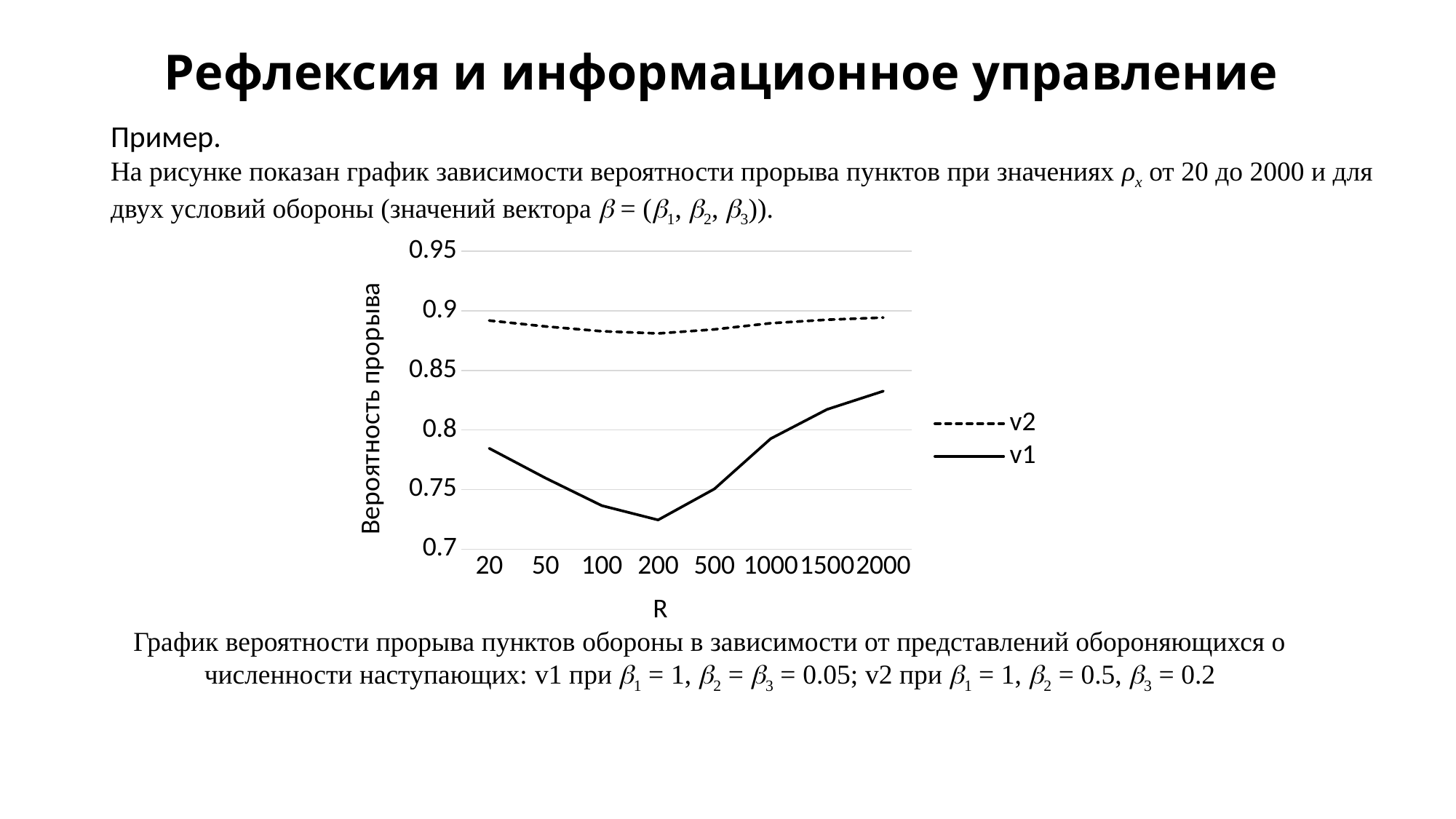
Which series is drawn with a dashed line? v2 At which value of R does the v1 series reach its lowest point? 200 Does the v1 series rise or fall between R = 200 and R = 2000? rise At which value of R does the v1 series reach its highest point? 2000 Does the v1 series rise or fall between R = 20 and R = 200? fall How many series does the legend list? 2 Is the value of v1 at R = 2000 greater or less than 0.8? greater Which series has the larger value at R = 500, v1 or v2? v2 How many values of R are marked on the x axis? 8 Is the value of v1 at R = 200 greater or less than 0.75? less What kind of chart is shown on the slide? line chart Is the value of v2 at R = 20 greater or less than 0.85? greater